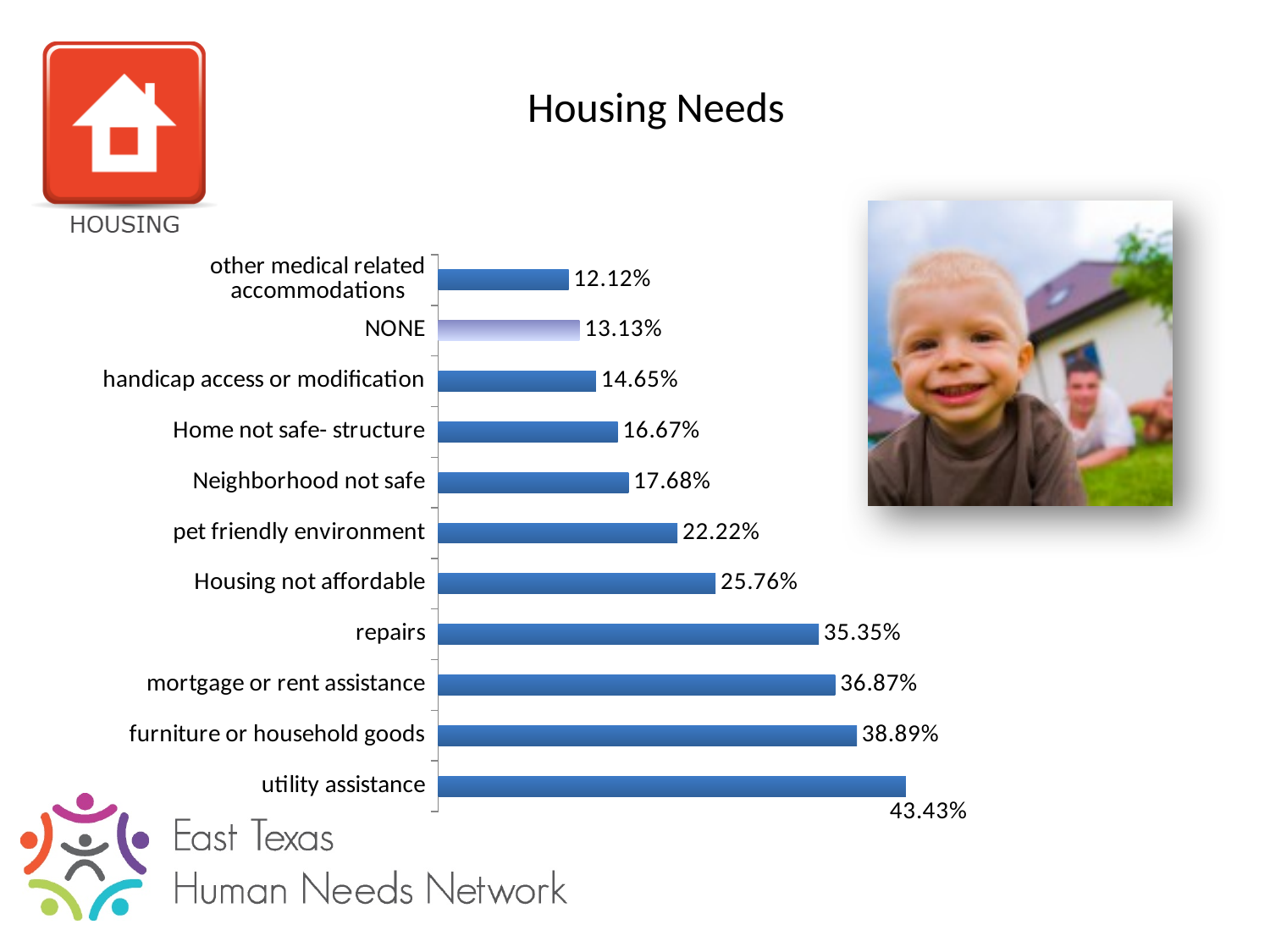
What is the difference between utility assistance and repairs? 8.08% Which category has the highest value? utility assistance What is the difference between furniture or household goods and mortgage or rent assistance? 2.02% How many categories are shown in the chart? 11 Which bar is coloured differently from the others? NONE What is the value for utility assistance? 43.43% What is the title of the chart? Housing Needs Which category has the lowest value? other medical related accommodations What is the value for NONE? 13.13% What kind of chart is shown on the slide? bar chart Which is larger, pet friendly environment or Neighborhood not safe? pet friendly environment What is the value for Housing not affordable? 25.76%